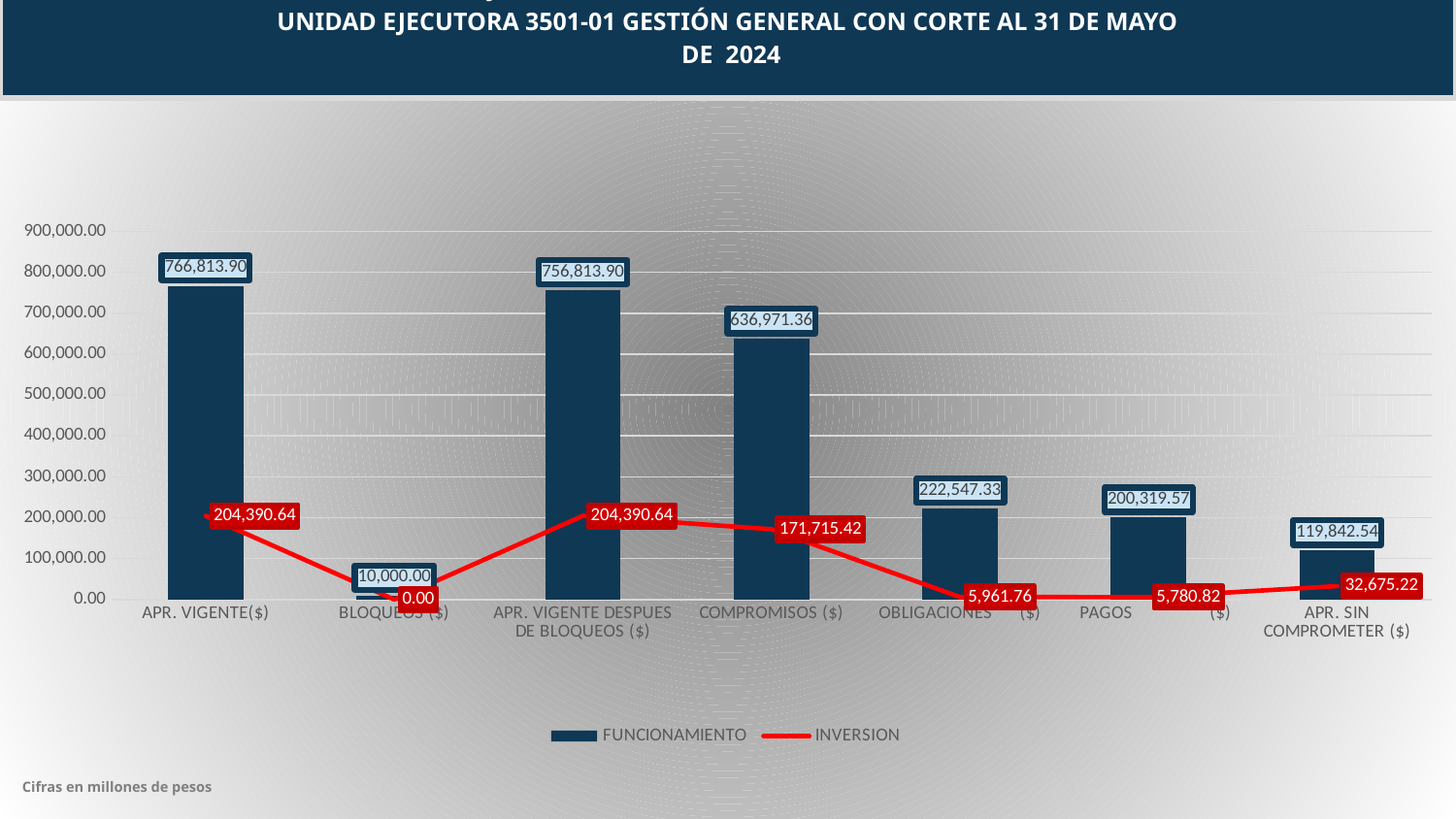
Which is larger, the FUNCIONAMIENTO value for COMPROMISOS ($) or for OBLIGACIONES ($)? COMPROMISOS ($) What is the FUNCIONAMIENTO value for PAGOS? 200,319.57 What is the INVERSION value for APR. SIN COMPROMETER ($)? 32,675.22 What is the difference between the FUNCIONAMIENTO values for OBLIGACIONES ($) and PAGOS? 22,227.76 What is the INVERSION value for COMPROMISOS ($)? 171,715.42 What is the FUNCIONAMIENTO value for APR. VIGENTE($)? 766,813.90 Which category has the highest FUNCIONAMIENTO value? APR. VIGENTE($) Which category has the lowest INVERSION value? BLOQUEOS ($) How many categories are shown on the x axis? 7 What is the difference between the FUNCIONAMIENTO values for APR. VIGENTE($) and APR. VIGENTE DESPUES DE BLOQUEOS ($)? 10,000.00 How many series does the legend list? 2 What kind of chart is shown on the slide? A bar chart combined with a line chart